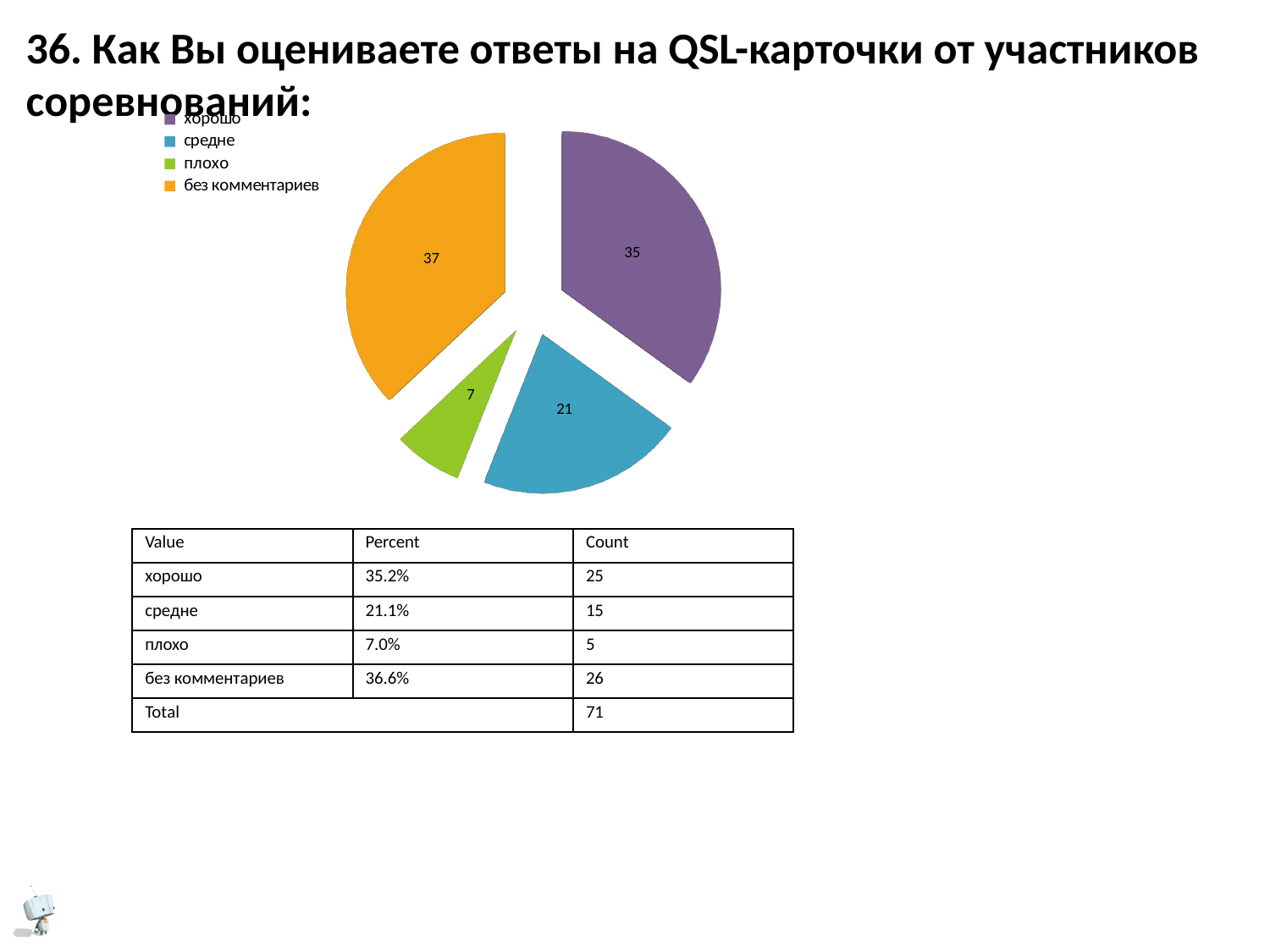
What is the data label shown on the средне slice of the pie chart? 21 Which slice is larger in the pie chart, средне or плохо? средне What is the data label shown on the без комментариев slice of the pie chart? 37 By how much does the data label for без комментариев exceed the data label for хорошо in the pie chart? 2 What kind of chart is shown on the slide? pie chart How many entries does the legend of the pie chart list? 4 How many slices does the pie chart have? 4 Which category has the largest slice in the pie chart? без комментариев Which category has the smallest slice in the pie chart? плохо What is the data label shown on the хорошо slice of the pie chart? 35 What is the data label shown on the плохо slice of the pie chart? 7 What colour is the хорошо slice in the pie chart? purple